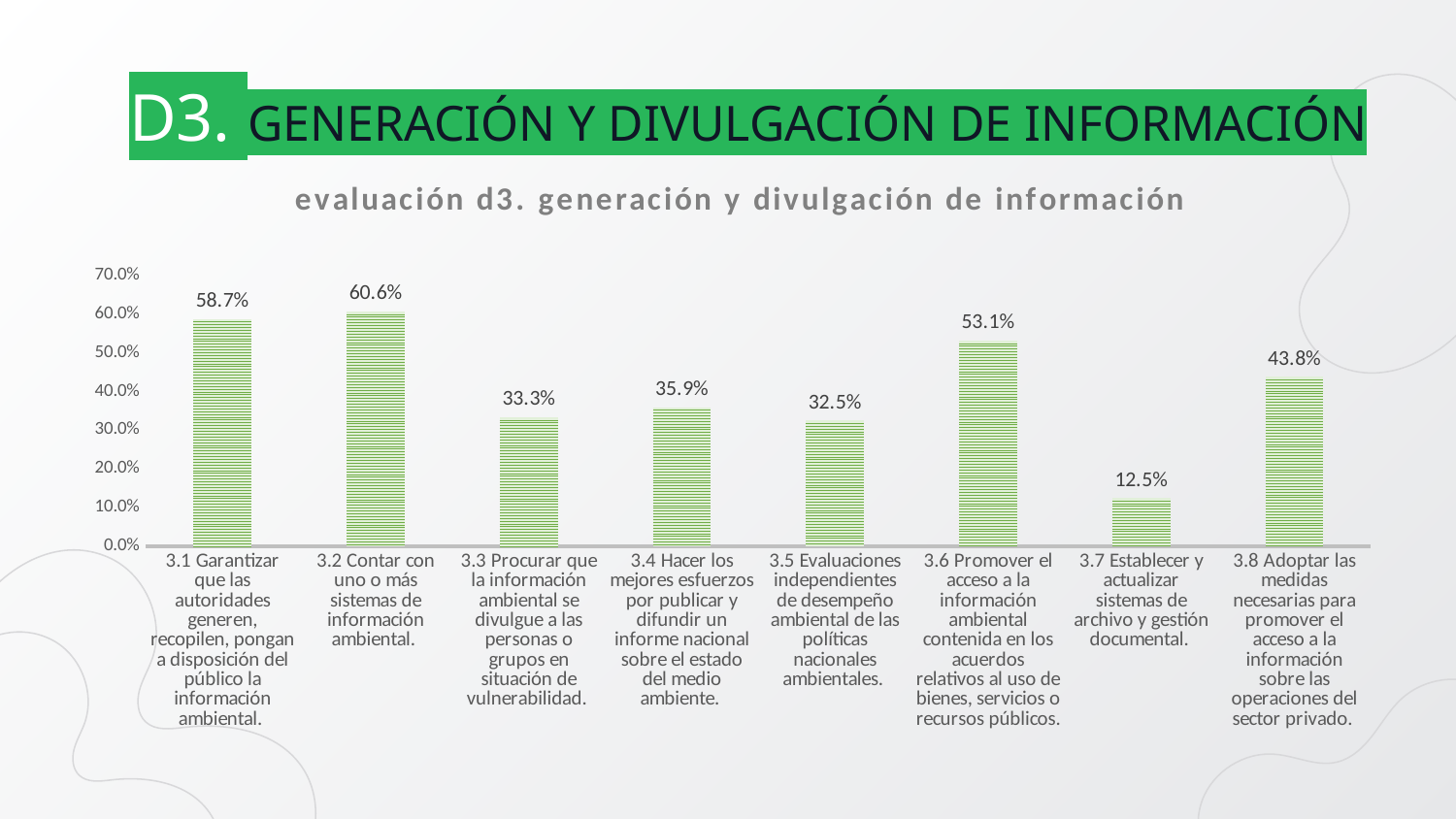
What is the value for category 3.6 (Promover el acceso a la información ambiental contenida en los acuerdos relativos al uso de bienes, servicios o recursos públicos)? 53.1% Which is larger, the value for category 3.4 or the value for category 3.5? 3.4 Hacer los mejores esfuerzos por publicar y difundir un informe nacional sobre el estado del medio ambiente. How many categories are shown in the chart? 8 What is the value for category 3.2 (Contar con uno o más sistemas de información ambiental)? 60.6% Which category has the lowest value? 3.7 Establecer y actualizar sistemas de archivo y gestión documental. What is the value for category 3.7 (Establecer y actualizar sistemas de archivo y gestión documental)? 12.5% Is the value for category 3.8 greater or less than 40.0%? greater Which category has the highest value? 3.2 Contar con uno o más sistemas de información ambiental. What is the difference between the values for category 3.8 and category 3.7? 31.3% What is the title of the chart? evaluación d3. generación y divulgación de información What kind of chart is shown on the slide? bar chart What is the difference between the values for category 3.2 and category 3.1? 1.9%